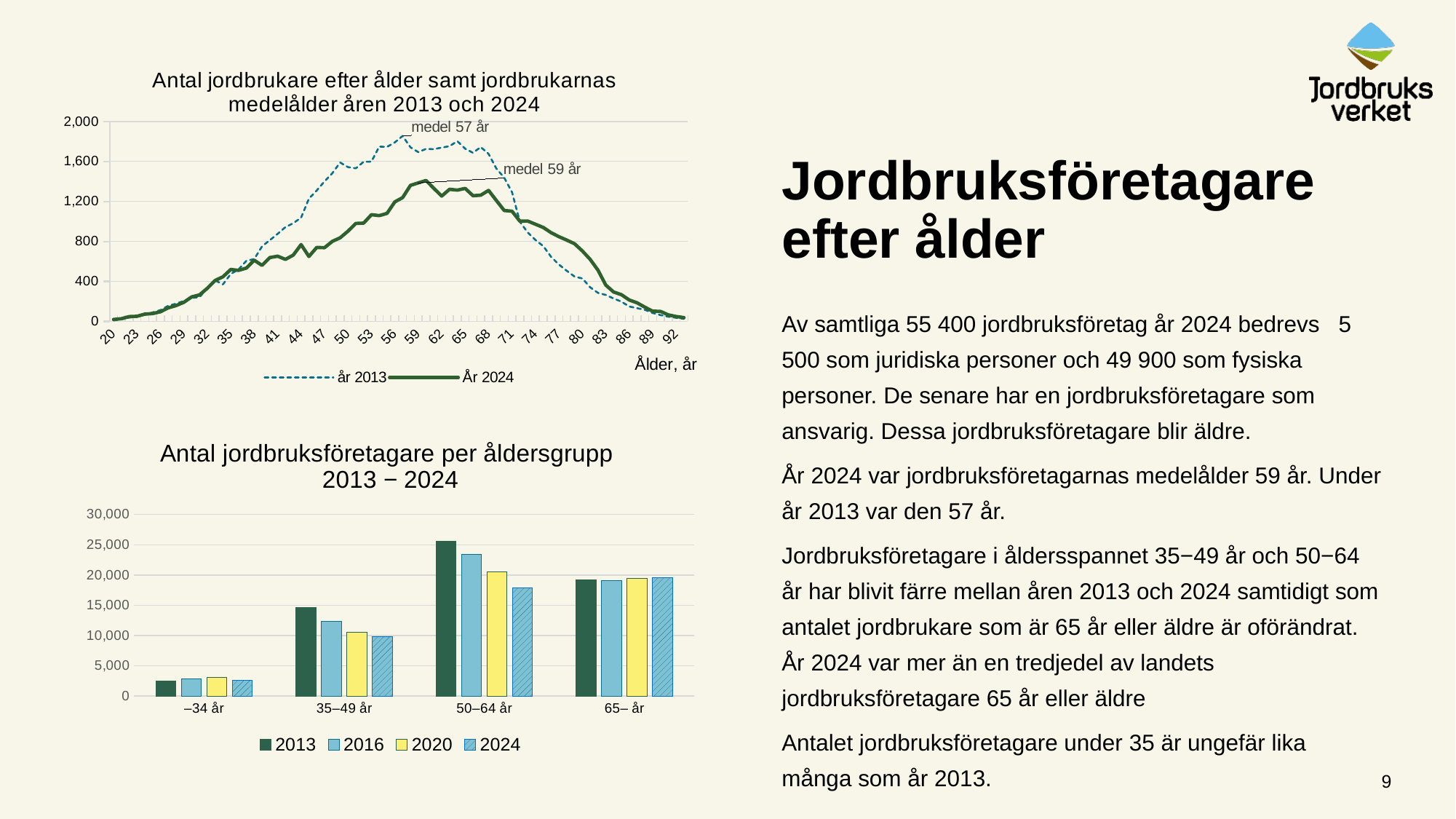
In the bottom chart, which age group has the lowest values? –34 år What kind of chart is the top chart, 'Antal jordbrukare efter ålder samt jordbrukarnas medelålder åren 2013 och 2024'? Line chart In the top chart, what mean age is annotated for the År 2024 series? medel 59 år What kind of chart is the bottom chart, 'Antal jordbruksföretagare per åldersgrupp 2013 − 2024'? Bar chart How many series does the legend of the bottom chart list? 4 In the bottom chart, do the values for 50–64 år rise or fall from 2013 to 2024? fall In the top chart, is the peak value of the År 2024 series greater or less than 1,600? less How many series does the legend of the top chart list? 2 How many age-group categories are shown in the bottom chart? 4 In the top chart, which series reaches the higher peak, år 2013 or År 2024? år 2013 In the top chart, is the peak value of the år 2013 series greater or less than 1,600? greater